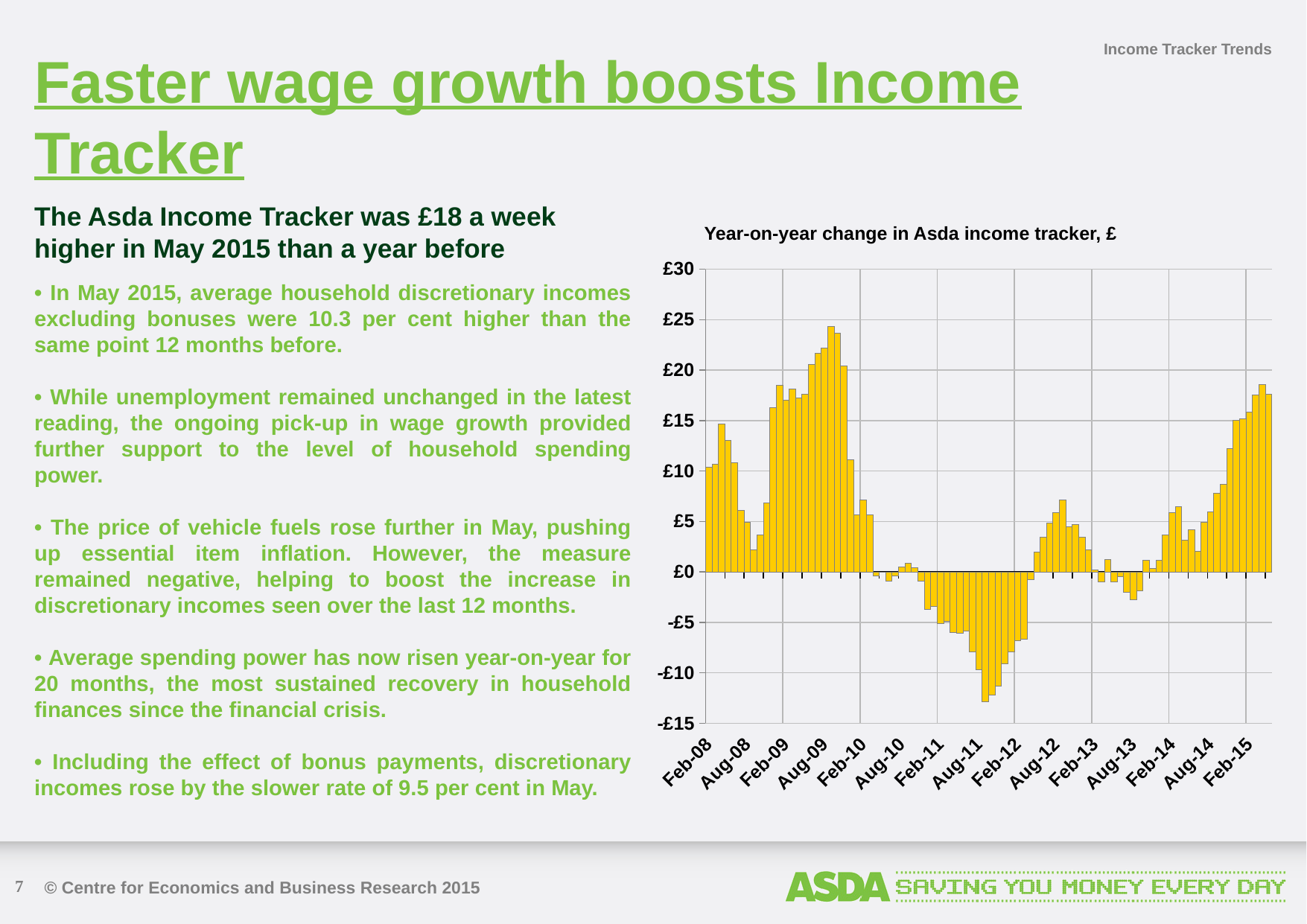
Is the value for Feb-12 greater or less than £0? less Is the value for Aug-11 greater or less than -£5? less What is the title of the chart? Year-on-year change in Asda income tracker, £ What colour are the bars in the chart? Yellow Is the value for Aug-09 greater or less than £20? greater Around which labelled period does the chart reach its highest value? Aug-09 Around which labelled period does the chart reach its lowest value? Aug-11 What kind of chart is shown on the slide? Bar chart How many date labels are shown on the x axis of the chart? 15 Which is larger, the value for Aug-09 or the value for Feb-15? Aug-09 Do the values rise or fall between Aug-13 and Feb-15? Rise